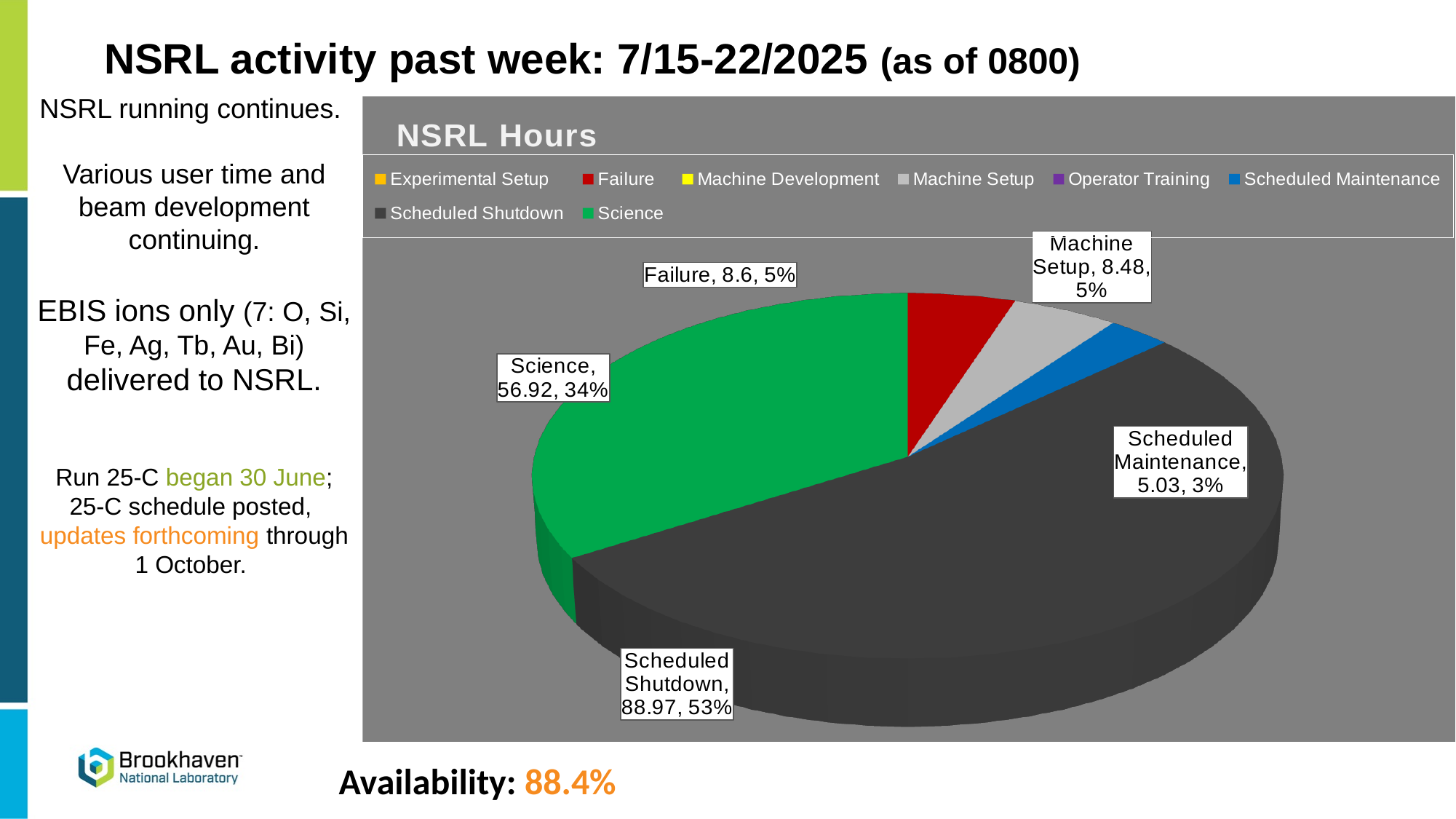
What type of chart is shown on the slide? Pie chart How many hours are labelled for Failure? 8.6 How many hours are labelled for Scheduled Shutdown? 88.97 How many hours are labelled for Scheduled Maintenance? 5.03 What percentage share of the pie does Machine Setup have? 5% Which category has the largest slice of the pie? Scheduled Shutdown What percentage share of the pie does Science have? 34% How many hours are labelled for Science? 56.92 What is the difference in hours between Scheduled Shutdown and Science? 32.05 What is the title of the chart? NSRL Hours Which labelled category has the smallest slice of the pie? Scheduled Maintenance How many entries does the chart legend list? 8